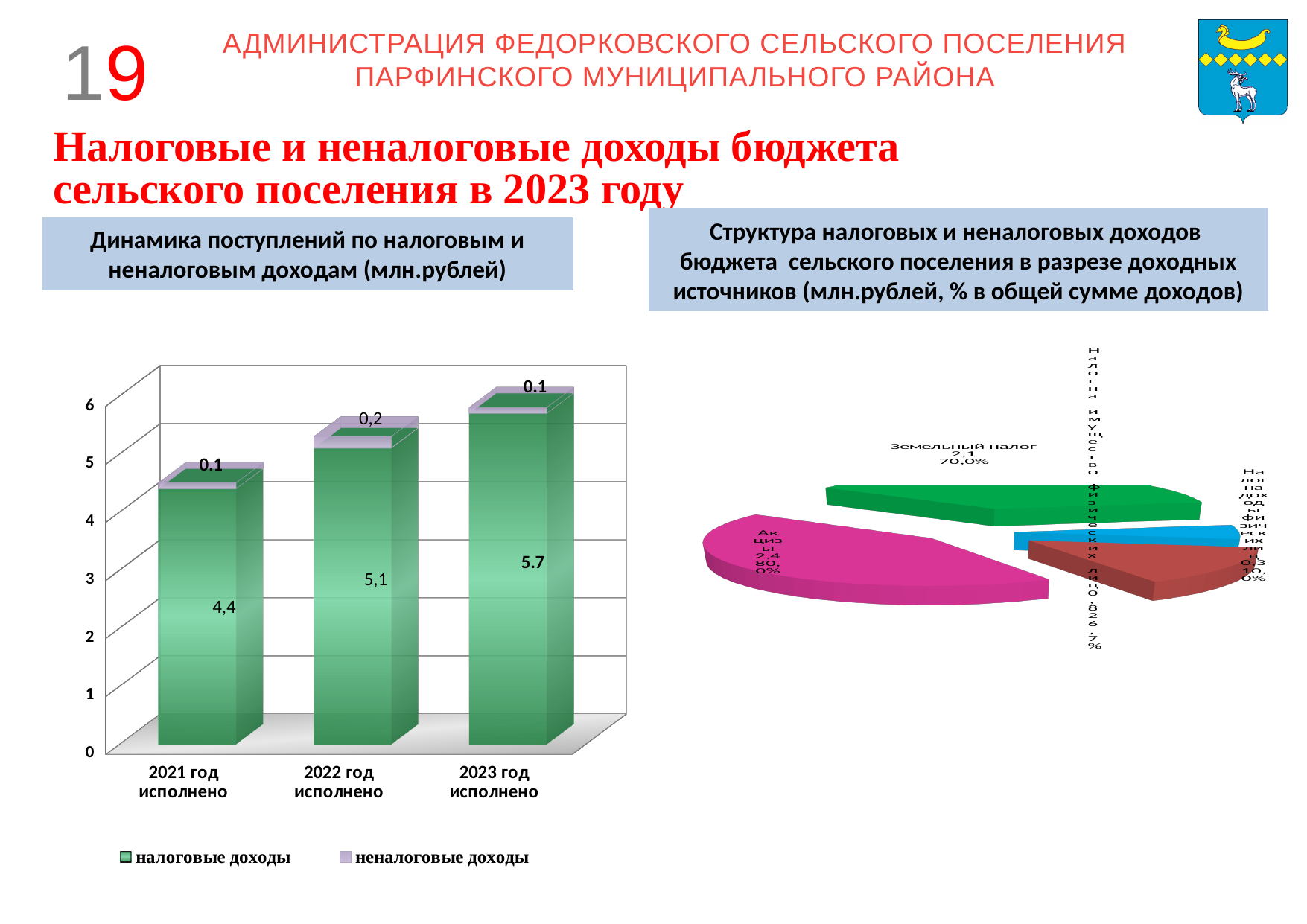
On the left chart 'Динамика поступлений по налоговым и неналоговым доходам', what is the value of неналоговые доходы for 2022 год исполнено? 0,2 On the left chart 'Динамика поступлений по налоговым и неналоговым доходам', which year has the highest налоговые доходы? 2023 год исполнено On the left chart 'Динамика поступлений по налоговым и неналоговым доходам', how many series does the legend list? 2 On the left chart 'Динамика поступлений по налоговым и неналоговым доходам', what is the difference between налоговые доходы in 2023 and 2021? 1,3 On the left chart 'Динамика поступлений по налоговым и неналоговым доходам', how many years are shown on the x axis? 3 On the left chart 'Динамика поступлений по налоговым и неналоговым доходам', what is the value of налоговые доходы for 2023 год исполнено? 5.7 On the left chart 'Динамика поступлений по налоговым и неналоговым доходам', do налоговые доходы rise or fall from 2021 to 2023? rise On the right pie chart 'Структура налоговых и неналоговых доходов', what value is shown for Земельный налог? 2,1 On the left chart 'Динамика поступлений по налоговым и неналоговым доходам', what is the value of налоговые доходы for 2021 год исполнено? 4,4 On the left chart 'Динамика поступлений по налоговым и неналоговым доходам', which year has the lowest налоговые доходы? 2021 год исполнено On the left chart 'Динамика поступлений по налоговым и неналоговым доходам', what is the value of налоговые доходы for 2022 год исполнено? 5,1 What kind of chart is the right chart 'Структура налоговых и неналоговых доходов'? pie chart